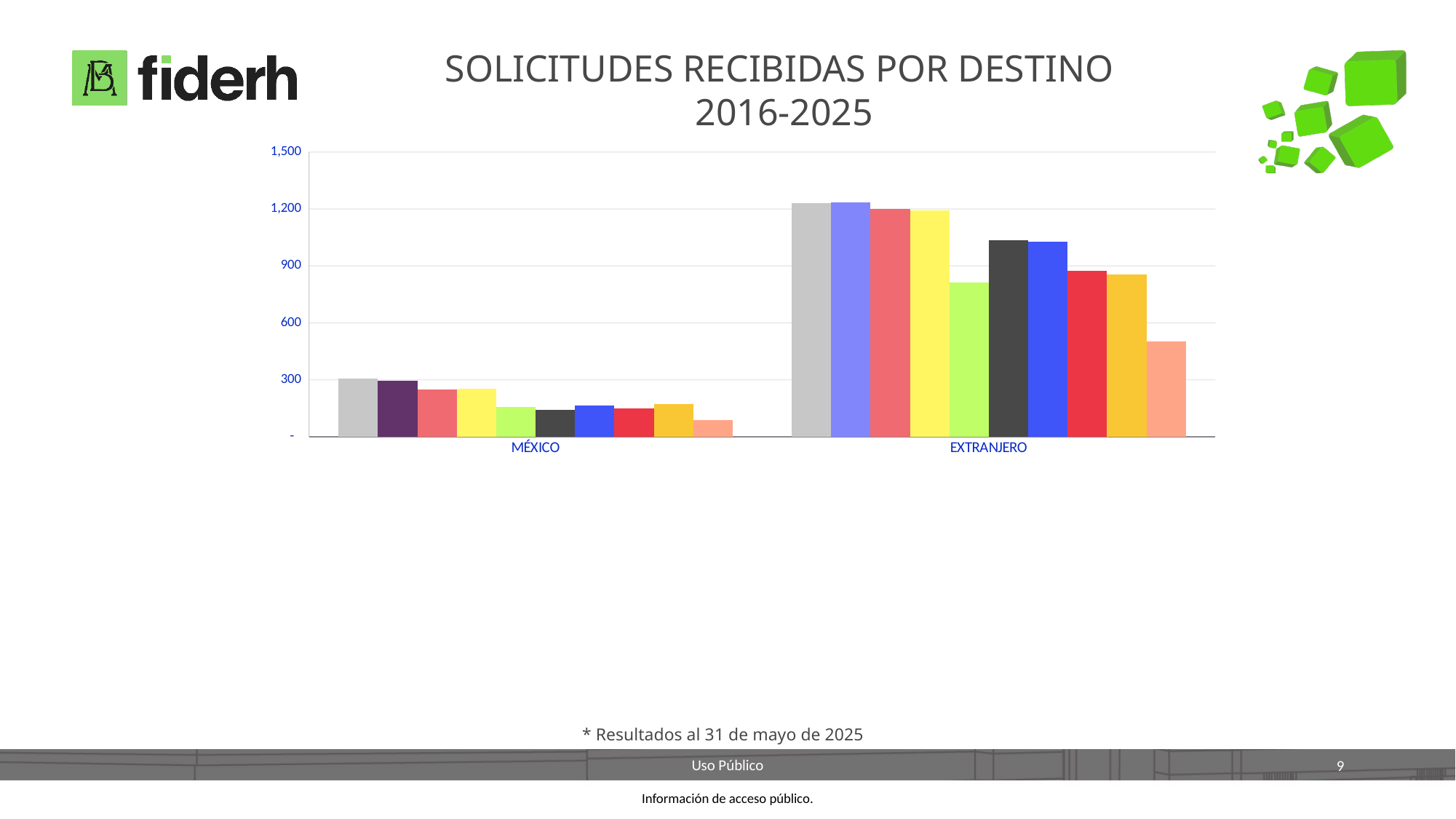
Within the EXTRANJERO category, do the bars generally rise or fall from left to right? fall How many bars are plotted for the EXTRANJERO category? 10 What kind of chart is shown on the slide? bar chart What is the highest value shown on the y axis of the chart? 1,500 What is the title of the chart on the slide? SOLICITUDES RECIBIDAS POR DESTINO 2016-2025 Is the value of the last (light orange) bar for MÉXICO greater or less than 300? less How many categories are shown on the x axis of the chart? 2 Is the value of the last (light orange) bar for EXTRANJERO greater or less than 600? less Is the value of the first (grey) bar for EXTRANJERO greater or less than 900? greater Which category has the taller bars overall, MÉXICO or EXTRANJERO? EXTRANJERO